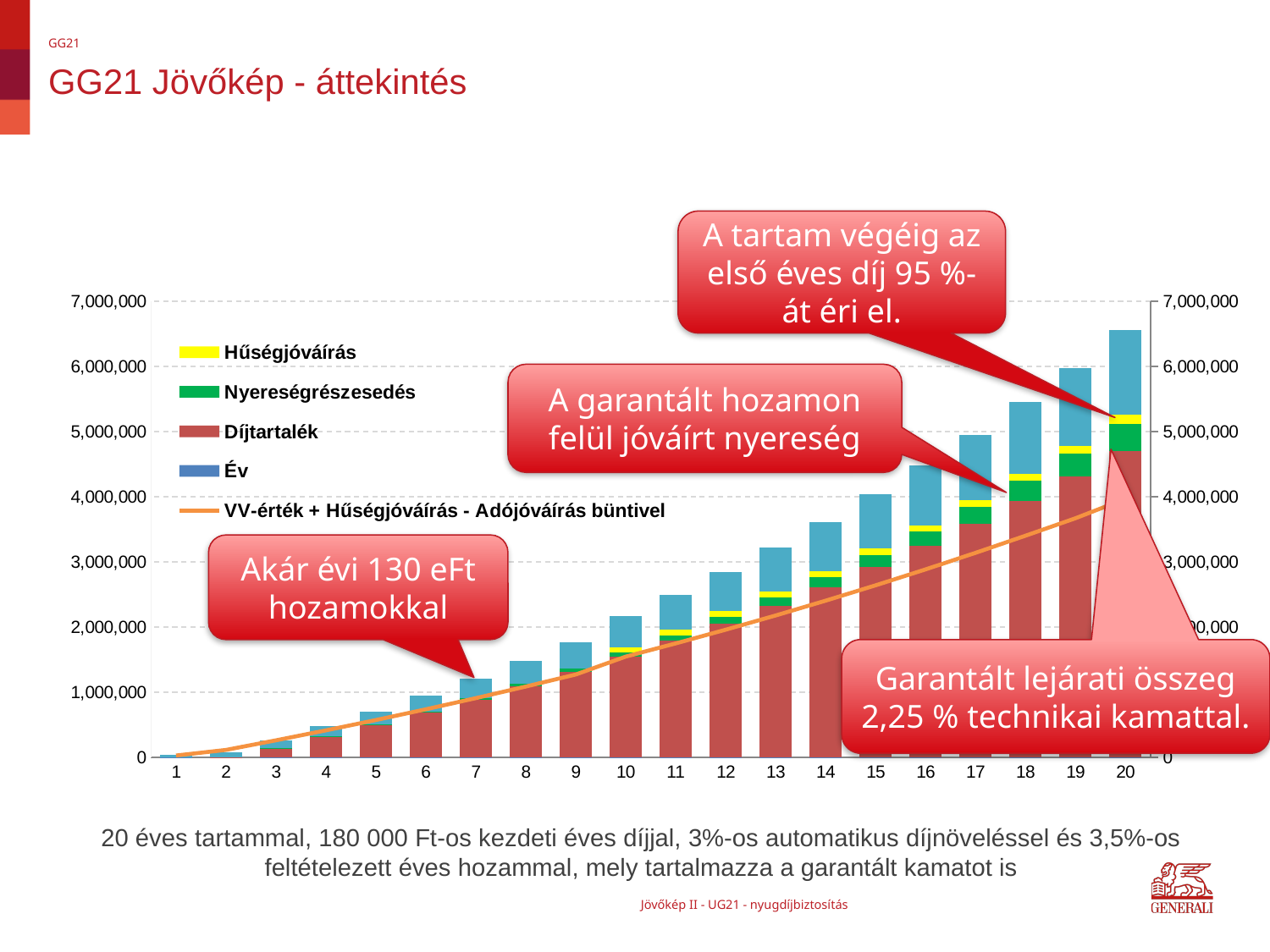
How many series does the chart's legend list? 5 What kind of chart is shown on the slide? combination bar and line chart Which stacked bar is taller, year 12 or year 8? 12 Is the total of the stacked bar for year 5 greater or less than 1,000,000? less Which year has the tallest stacked bar? 20 Is the total of the stacked bar for year 14 greater or less than 3,000,000? greater Which year has the shortest stacked bar? 1 Is the total of the stacked bar for year 20 greater or less than 6,000,000? greater Do the stacked bar totals rise or fall as the year increases along the x axis? rise What colour is used for the Hűségjóváírás series in the legend? yellow How many categories (years) are shown on the x axis of the chart? 20